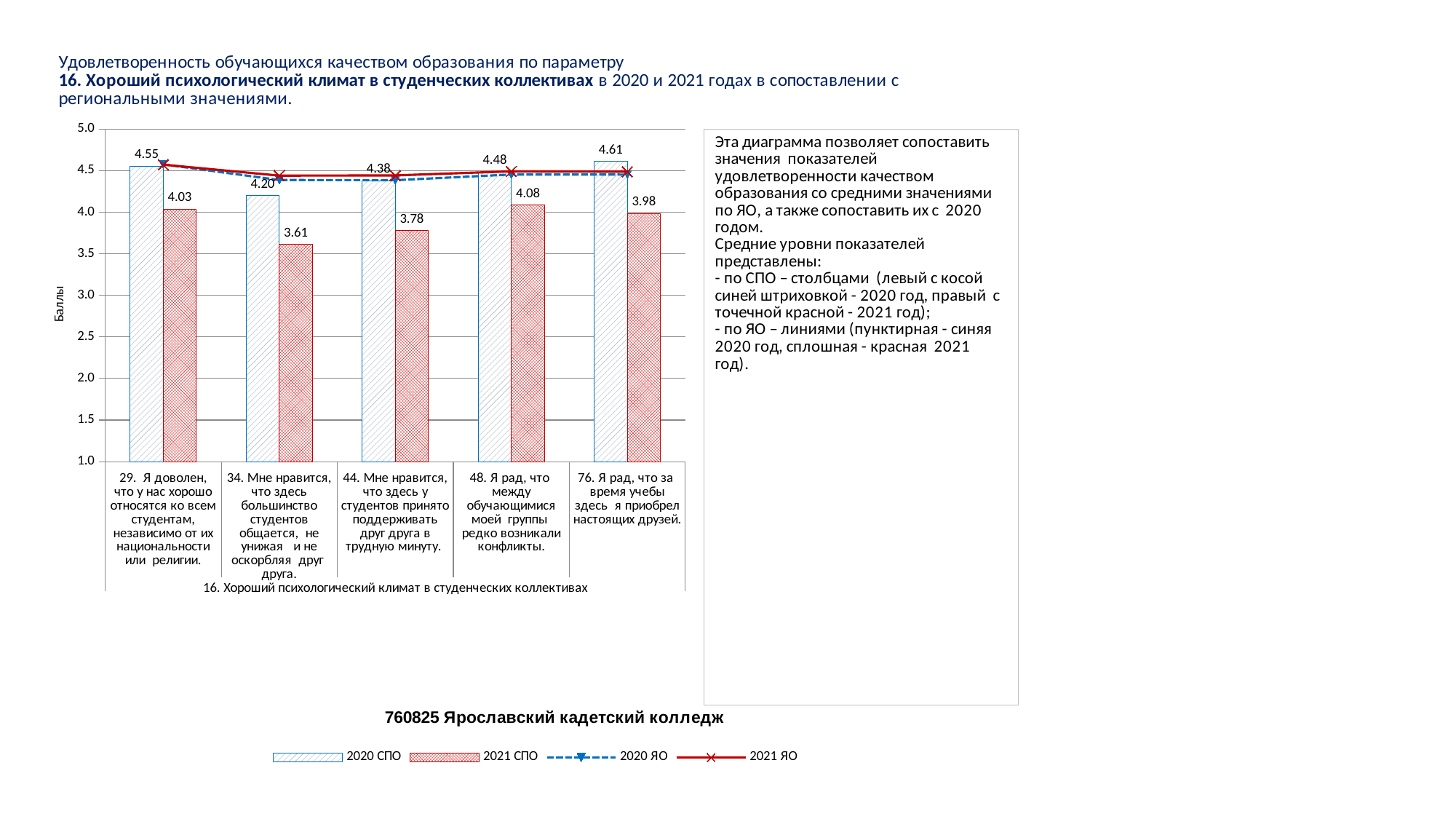
What is the difference between the 2020 СПО and 2021 СПО values for item 76? 0.63 Which item has the lowest 2021 СПО value? 34. Мне нравится, что здесь большинство студентов общается, не унижая и не оскорбляя друг друга. How many series does the legend list? 4 What is the 2021 СПО value for item 48 (Я рад, что между обучающимися моей группы редко возникали конфликты)? 4.08 How many survey items (categories) are shown on the x axis? 5 For item 44, which is larger: the 2020 СПО value or the 2021 СПО value? 2020 СПО What is the 2021 СПО value for item 34 (Мне нравится, что здесь большинство студентов общается, не унижая и не оскорбляя друг друга)? 3.61 Which item has the highest 2020 СПО value? 76. Я рад, что за время учебы здесь я приобрел настоящих друзей. Is the 2021 ЯО value for item 29 greater or less than 4.0? greater What is the 2020 СПО value for item 29 (Я доволен, что у нас хорошо относятся ко всем студентам)? 4.55 What is the label of the vertical axis? Баллы What kind of chart is shown on the slide? Combined bar and line chart